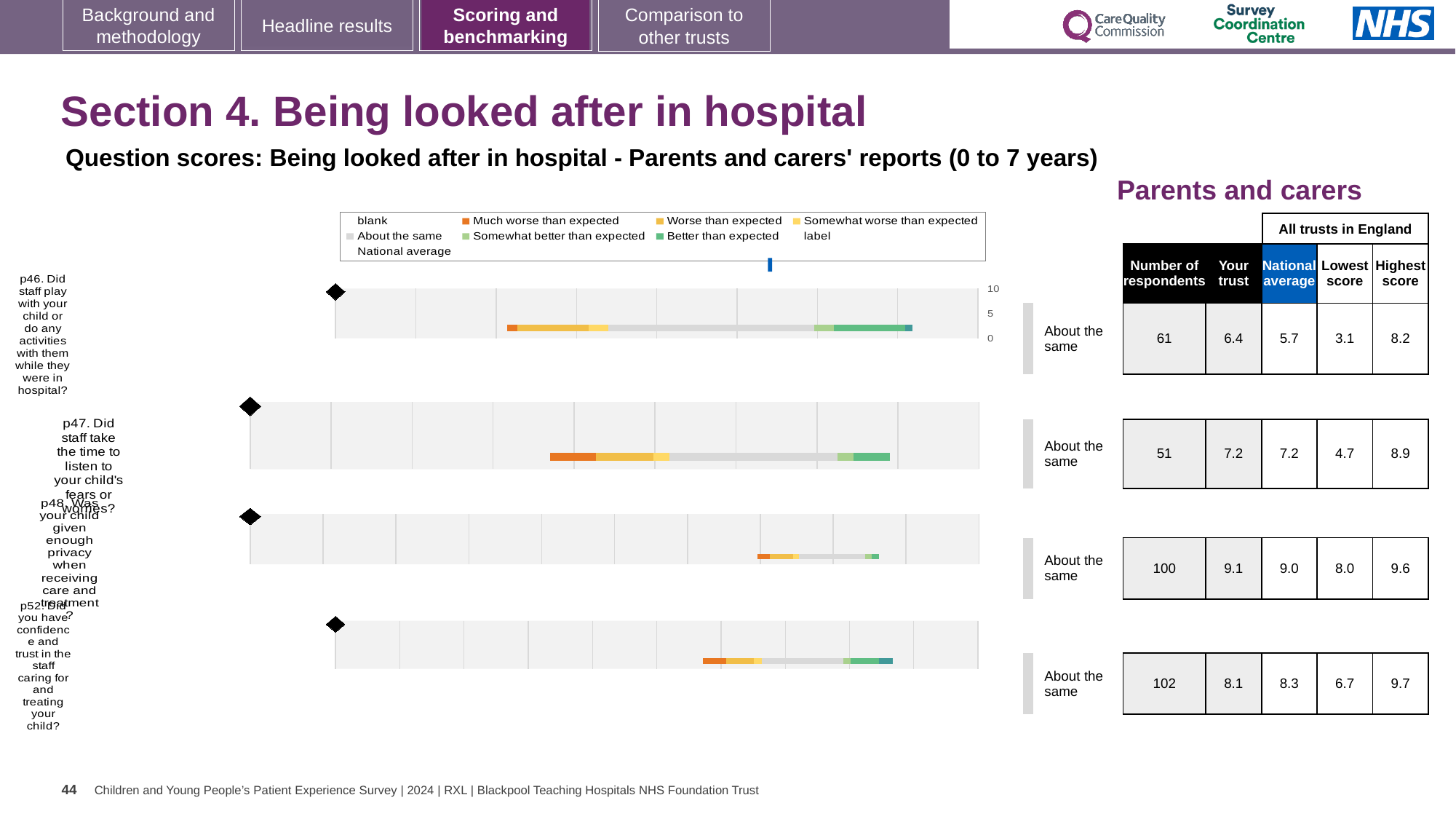
For question p52, which is larger: the 'Your trust' score or the national average? National average How many survey questions are charted on this slide? 4 What is the 'Your trust' score for question p47 (Did staff take the time to listen to your child's fears or worries?)? 7.2 What is the lowest score across all trusts in England for question p47? 4.7 How many respondents are shown for question p46 (Did staff play with your child or do any activities with them while they were in hospital?)? 61 What benchmark category is shown next to each of the four question charts? About the same What is the highest score across all trusts in England for question p52 (Did you have confidence and trust in the staff caring for and treating your child?)? 9.7 Which question has the lowest number of respondents? p47 What kind of chart is used to show each question's score range? Bar chart Which question has the highest 'Your trust' score? p48 What is the national average score for question p48 (Was your child given enough privacy when receiving care and treatment?)? 9.0 For question p46, what is the difference between the highest score and the lowest score across all trusts in England? 5.1